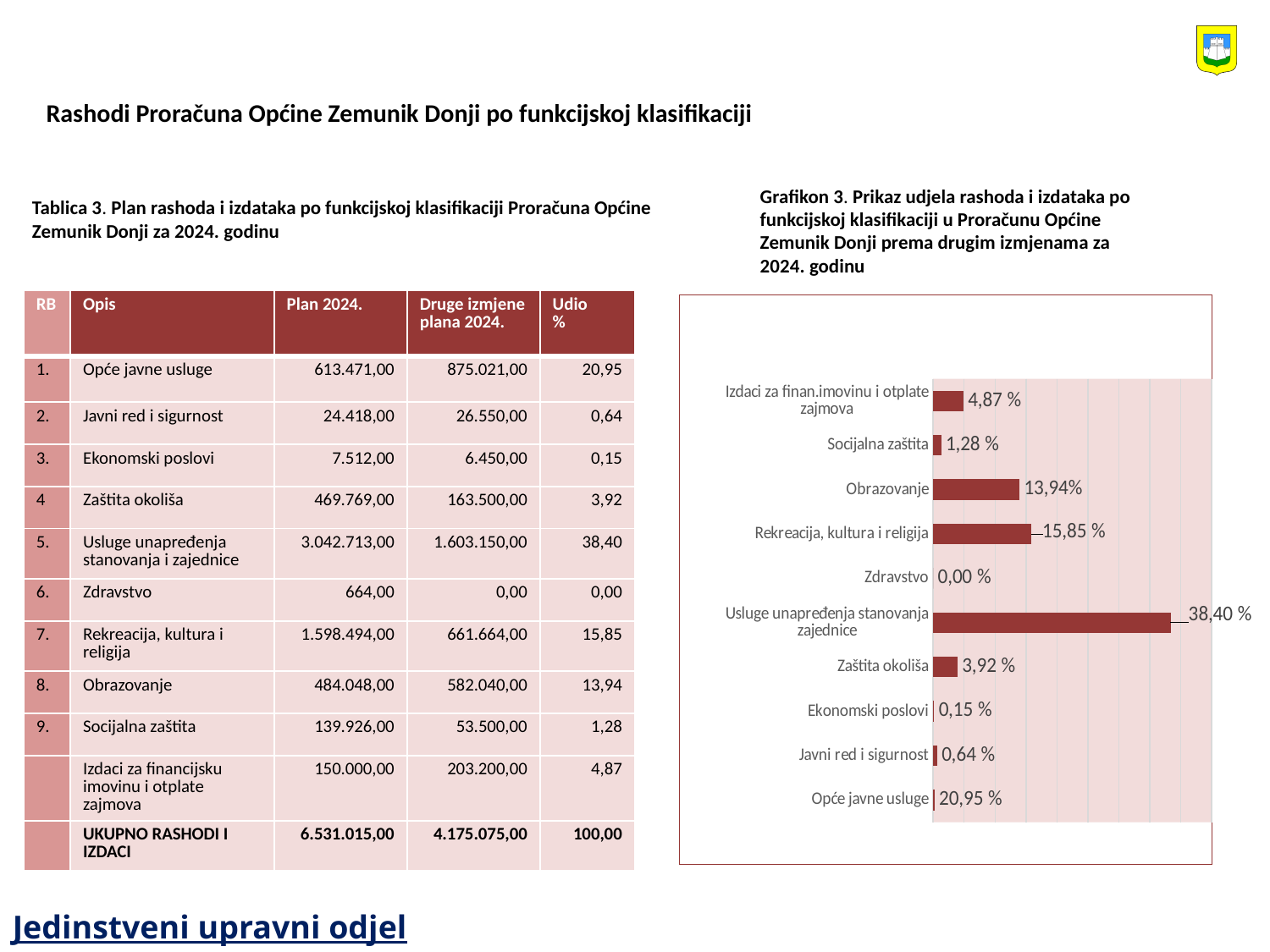
In Grafikon 3, what is the value shown for Zaštita okoliša? 3,92 % In Grafikon 3, what is the difference between the values for Usluge unapređenja stanovanja zajednice and Rekreacija, kultura i religija? 22,55 % In Grafikon 3, which is larger: the value for Obrazovanje or the value for Zaštita okoliša? Obrazovanje In Grafikon 3, what is the value shown for Socijalna zaštita? 1,28 % What type of chart is Grafikon 3? bar chart In Grafikon 3, what is the value shown for Obrazovanje? 13,94% In Grafikon 3, what is the value shown for Rekreacija, kultura i religija? 15,85 % In Grafikon 3, which category has the lowest value? Zdravstvo In Grafikon 3, which category has the highest value? Usluge unapređenja stanovanja zajednice In Grafikon 3, what is the value shown for Izdaci za finan.imovinu i otplate zajmova? 4,87 % How many categories are shown in Grafikon 3? 10 In Grafikon 3, what is the value shown for Ekonomski poslovi? 0,15 %